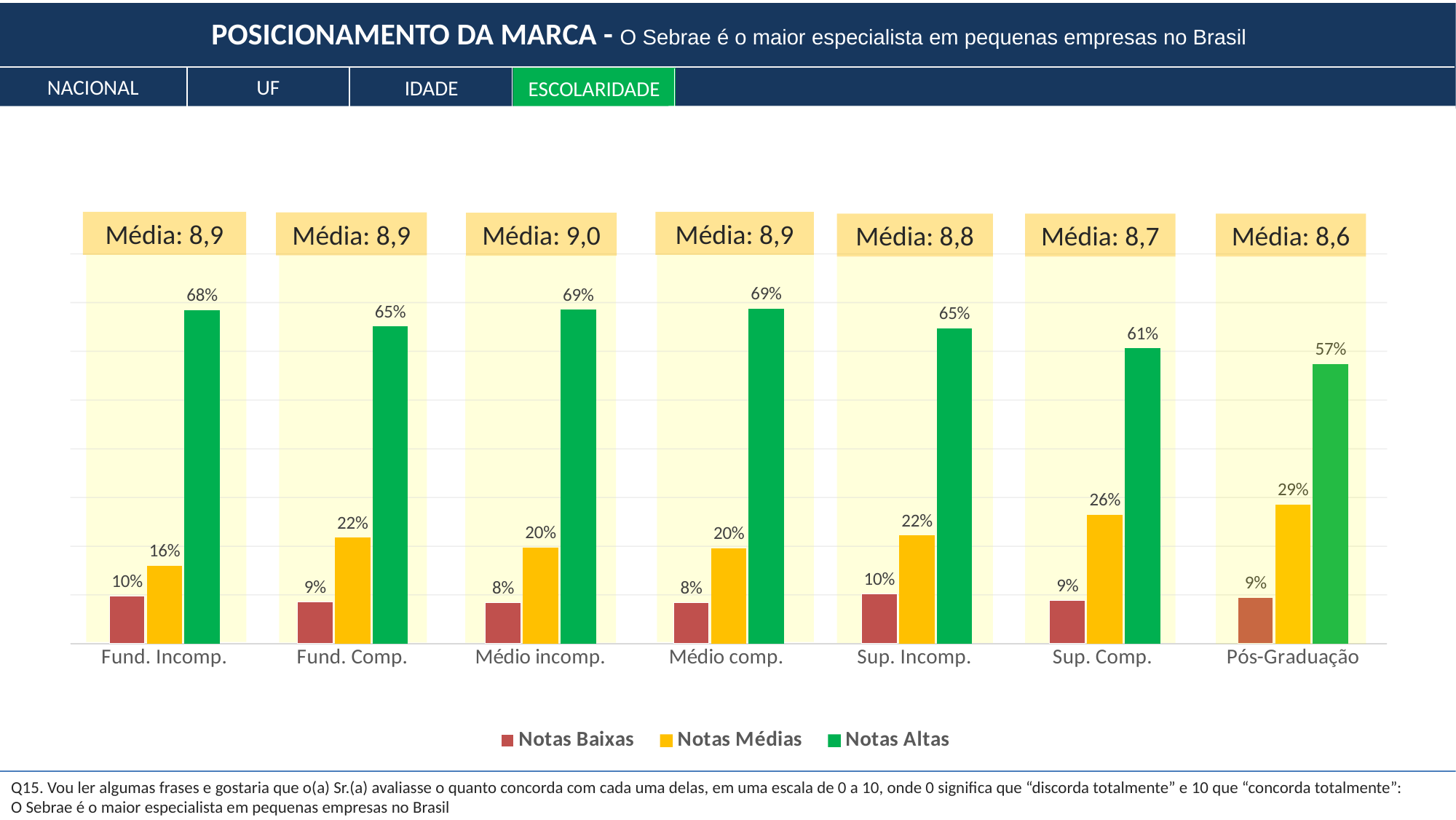
What kind of chart is shown on the slide? bar chart What is the Notas Baixas value for Sup. Incomp.? 10% Which category has the lowest Notas Altas value? Pós-Graduação What is the Média shown above the Médio incomp. category? 9,0 Which category has the highest Notas Médias value? Pós-Graduação What is the Notas Médias value for Sup. Comp.? 26% How many education categories are shown on the x axis? 7 What is the difference between the Notas Altas values for Médio comp. and Pós-Graduação? 12% Do the Notas Altas values rise or fall from Sup. Incomp. to Pós-Graduação? fall How many series does the legend list? 3 Which is larger, the Notas Médias value for Fund. Comp. or for Fund. Incomp.? Fund. Comp. What is the Notas Altas value for Pós-Graduação? 57%